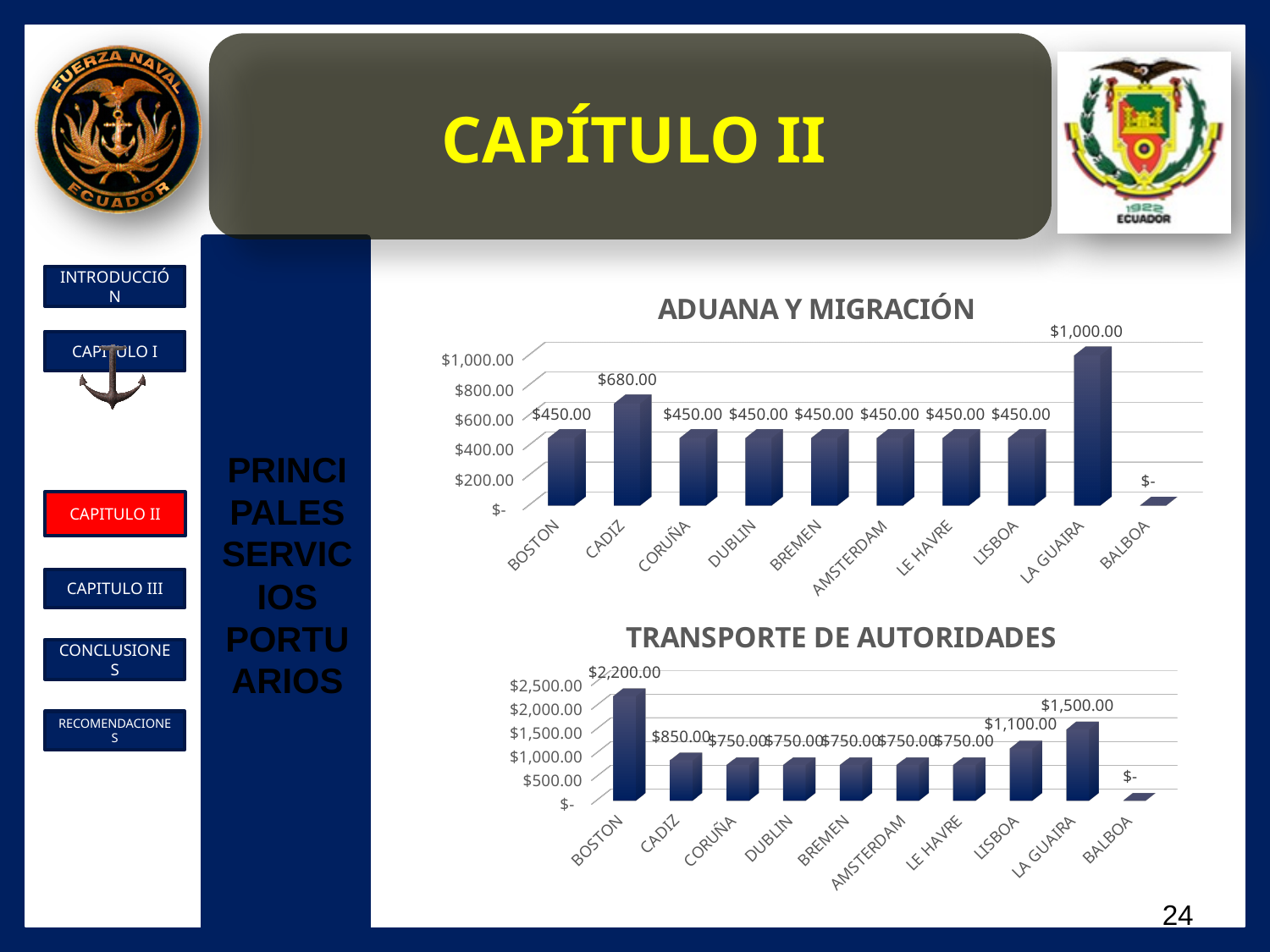
What kind of chart is the TRANSPORTE DE AUTORIDADES chart? Bar chart In the TRANSPORTE DE AUTORIDADES chart, which port has the highest value? BOSTON In the ADUANA Y MIGRACIÓN chart, which port has the highest value? LA GUAIRA In the TRANSPORTE DE AUTORIDADES chart, what is the difference between the values for BOSTON and CADIZ? $1,350.00 In the ADUANA Y MIGRACIÓN chart, how many ports are shown on the x axis? 10 In the ADUANA Y MIGRACIÓN chart, what is the value for CADIZ? $680.00 In the TRANSPORTE DE AUTORIDADES chart, what is the value for LISBOA? $1,100.00 In the ADUANA Y MIGRACIÓN chart, what is the difference between the values for LA GUAIRA and CADIZ? $320.00 In the ADUANA Y MIGRACIÓN chart, what is the value for BALBOA? $- In the TRANSPORTE DE AUTORIDADES chart, what is the value for BOSTON? $2,200.00 In the TRANSPORTE DE AUTORIDADES chart, which is larger, the value for LA GUAIRA or the value for LISBOA? LA GUAIRA What is the title of the upper chart on the slide? ADUANA Y MIGRACIÓN